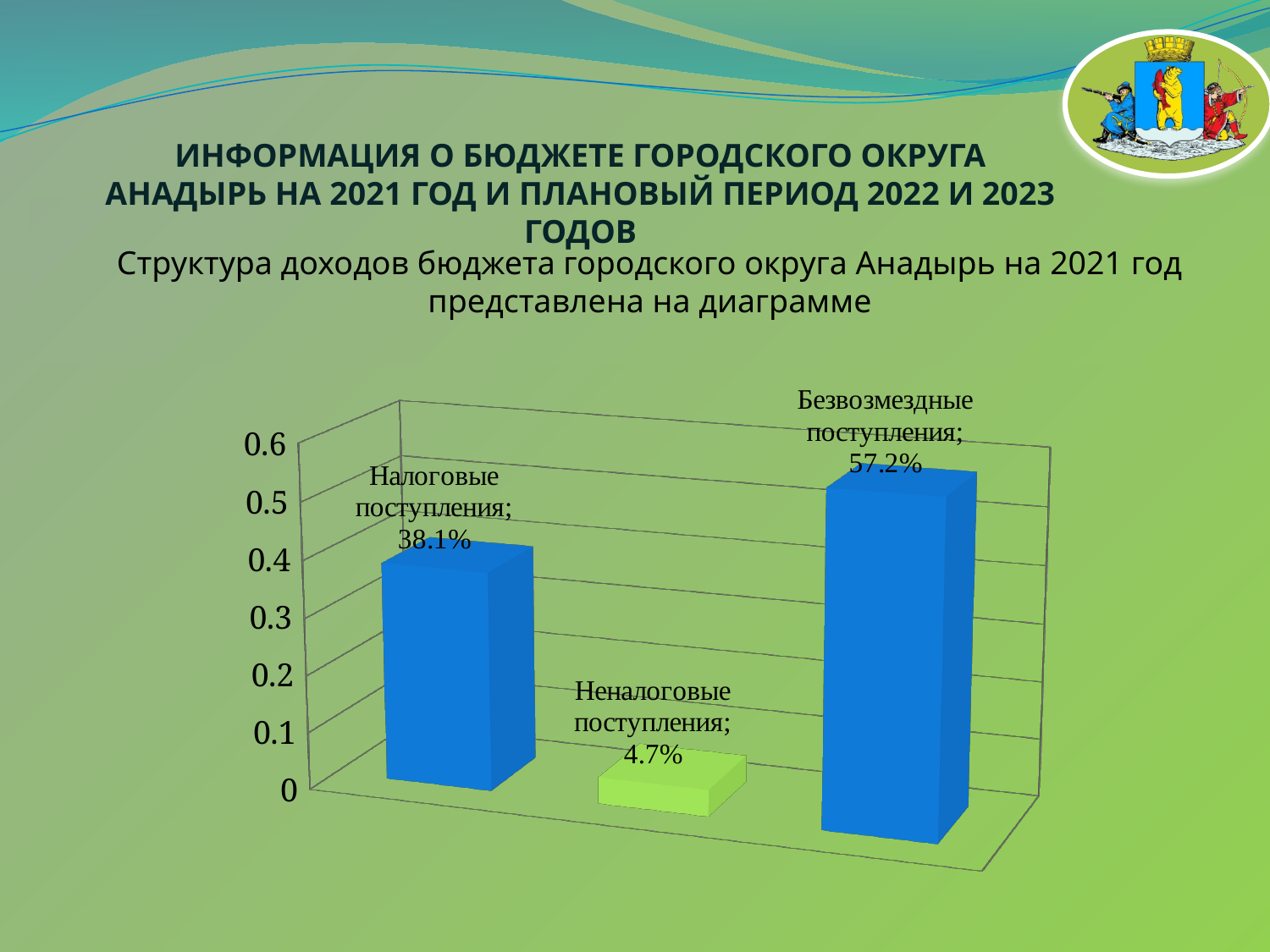
What is the value for Налоговые поступления? 38.1% What is the highest value shown on the vertical axis? 0.6 Which is larger, Налоговые поступления or Неналоговые поступления? Налоговые поступления Is the value for Безвозмездные поступления greater or less than 0.5? greater What is the difference between Налоговые поступления and Неналоговые поступления? 33.4% What kind of chart is shown on the slide? bar chart How many categories are shown in the chart? 3 Which category has the highest value? Безвозмездные поступления What is the value for Безвозмездные поступления? 57.2% Which category has the lowest value? Неналоговые поступления What is the value for Неналоговые поступления? 4.7% What is the difference between Безвозмездные поступления and Налоговые поступления? 19.1%